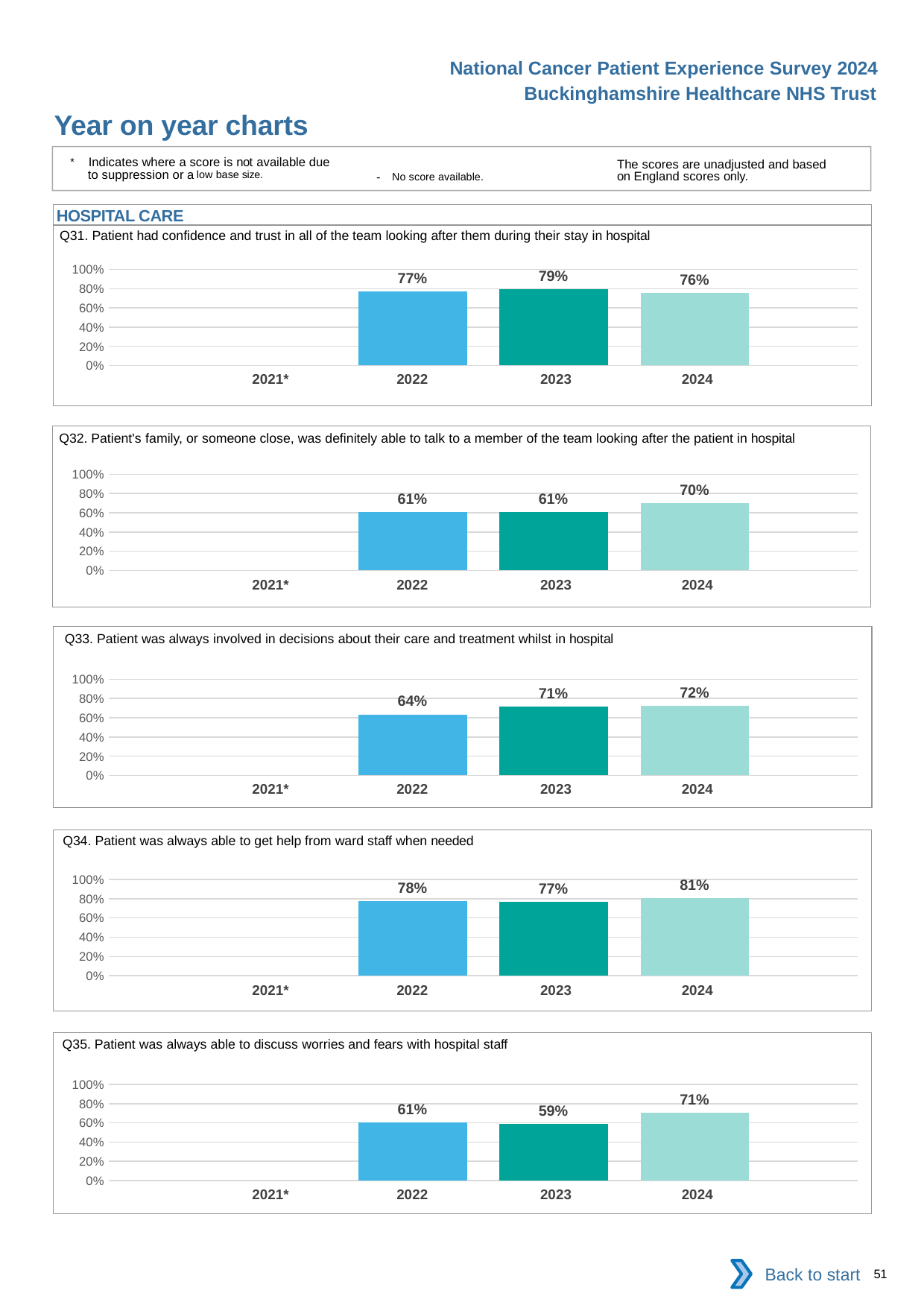
In the Q34 chart, how many years have a bar plotted? 3 In the Q33 chart, do the values rise or fall from 2022 to 2024? rise In the Q35 chart, what is the difference between the 2024 and 2023 values? 12% In the Q34 chart, which year has the highest value? 2024 In the Q31 chart, what is the value for 2023? 79% In the Q35 chart, is the value for 2023 greater or less than 80%? less In the Q32 chart, what is the value for 2024? 70% In the Q35 chart, what is the value for 2022? 61% In the Q33 chart, what is the difference between the 2023 and 2022 values? 7% In the Q33 chart, which year has the lowest value? 2022 In the Q31 chart, which is larger, the value for 2022 or the value for 2024? 2022 What kind of chart is the Q32 chart? bar chart